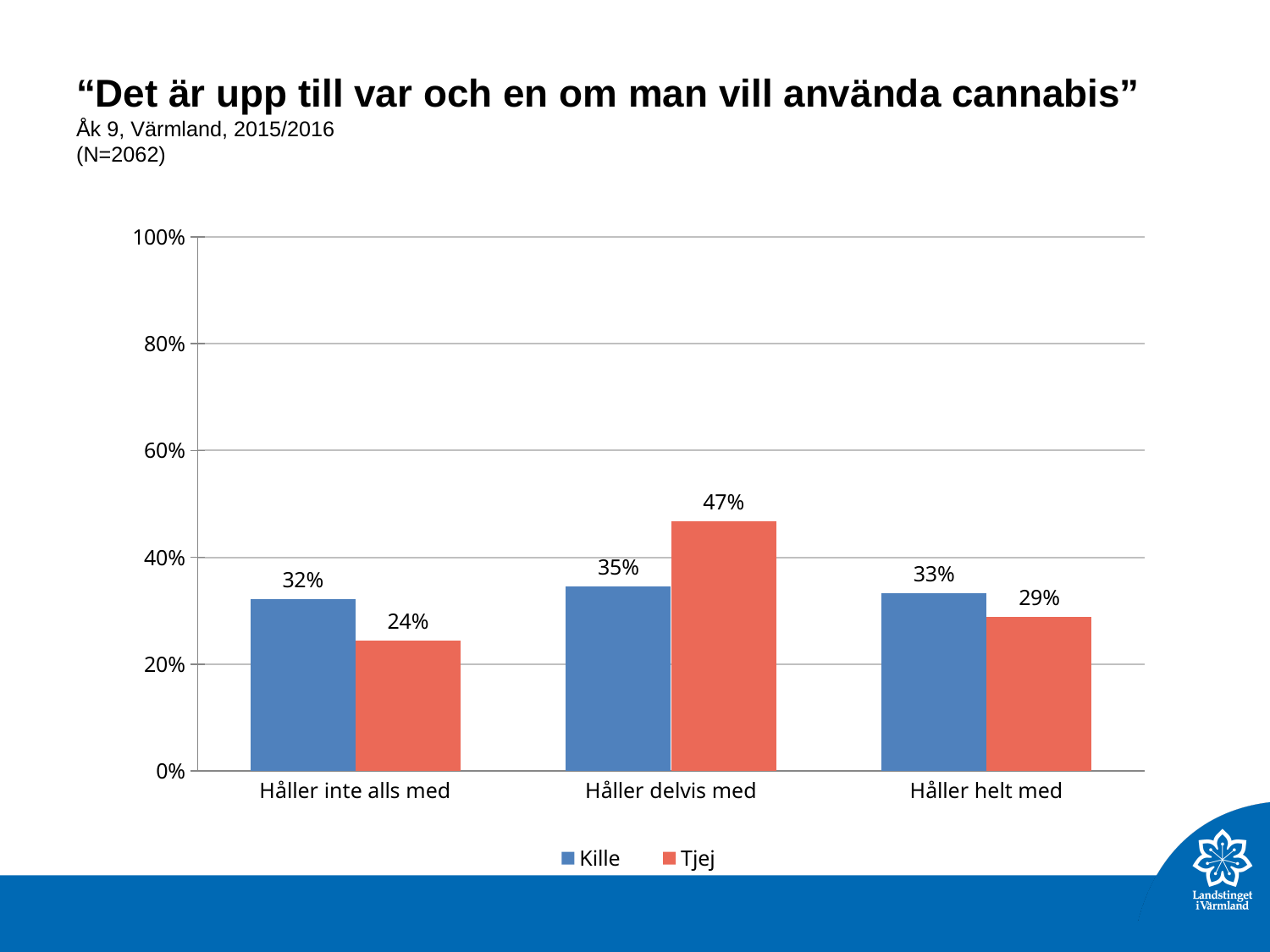
What is the value for Tjej in the "Håller helt med" category? 29% Which category has the highest value for Tjej? Håller delvis med Is the value for Tjej in "Håller delvis med" greater or less than 40%? greater Which category has the lowest value for Tjej? Håller inte alls med What is the value for Tjej in the "Håller delvis med" category? 47% What is the value for Kille in the "Håller inte alls med" category? 32% How many categories are shown on the x axis? 3 In the "Håller inte alls med" category, which series has the larger value, Kille or Tjej? Kille How many series does the legend list? 2 What are the two series named in the legend? Kille and Tjej What kind of chart is shown on the slide? Bar chart What is the difference between the Tjej and Kille values in the "Håller delvis med" category? 12%